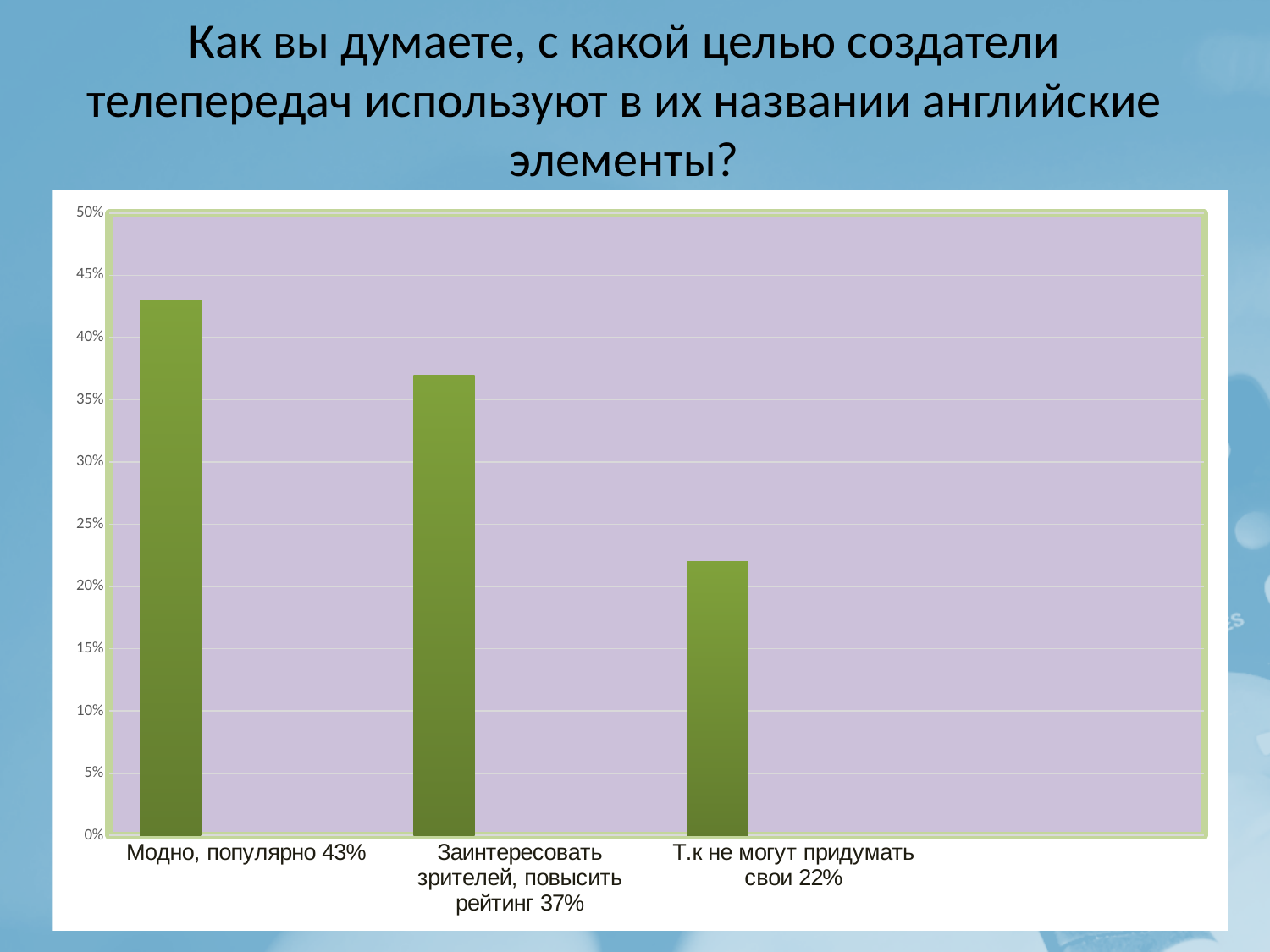
What is the difference between the values for "Модно, популярно" and "Заинтересовать зрителей, повысить рейтинг"? 6% Which category has the lowest value? Т.к не могут придумать свои How many categories are shown in the chart? 3 What value is shown for the category "Заинтересовать зрителей, повысить рейтинг"? 37% What value is shown for the category "Т.к не могут придумать свои"? 22% What value is shown for the category "Модно, популярно"? 43% What is the difference between the values for "Модно, популярно" and "Т.к не могут придумать свои"? 21% Is the value for "Заинтересовать зрителей, повысить рейтинг" greater or less than 40%? less What kind of chart is shown on the slide? bar chart Do the values rise or fall from left to right across the categories? fall Which is larger: the value for "Заинтересовать зрителей, повысить рейтинг" or the value for "Т.к не могут придумать свои"? Заинтересовать зрителей, повысить рейтинг Which category has the highest value? Модно, популярно